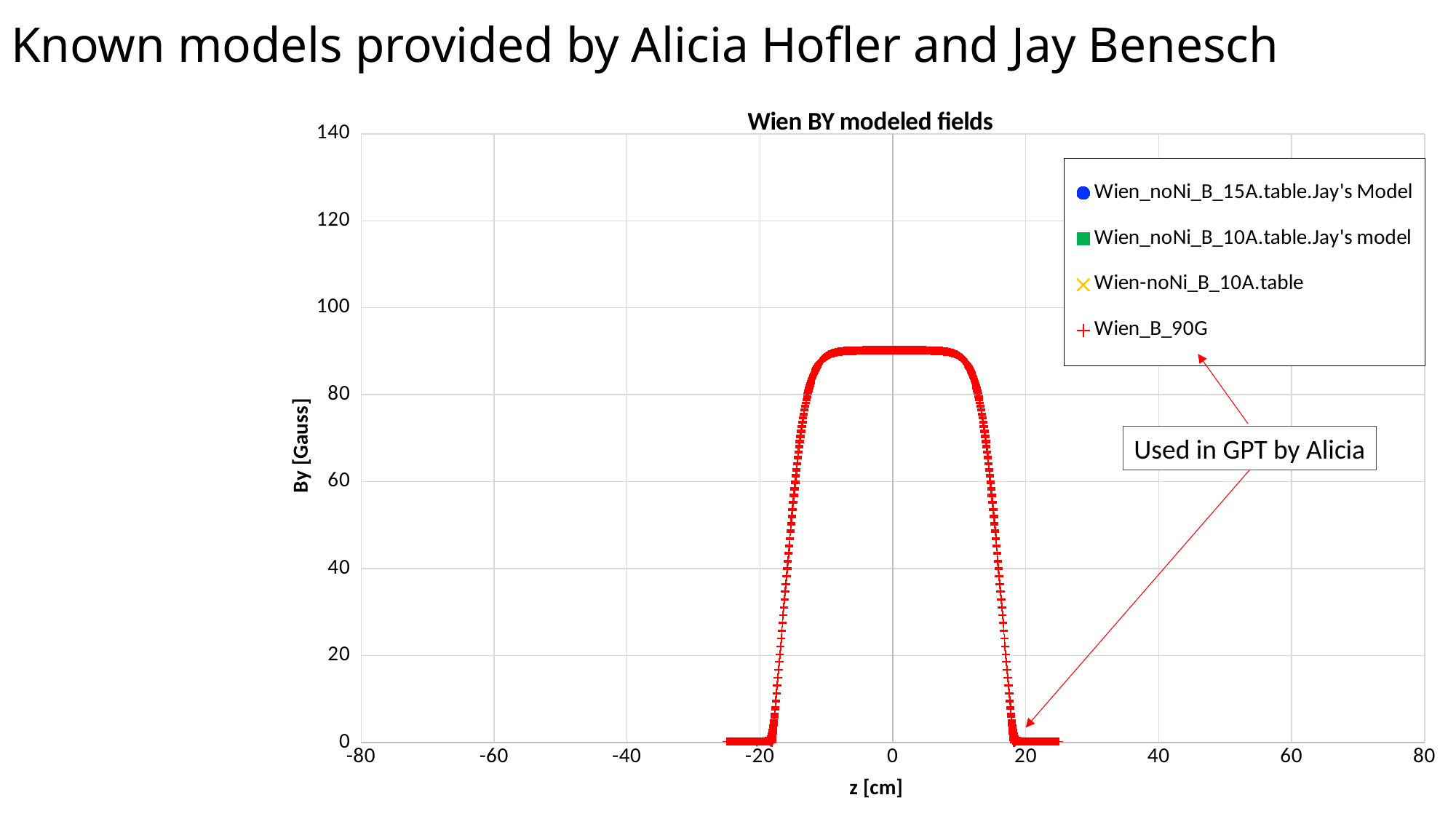
How many series does the legend of the chart list? 4 Do the values of the Wien_B_90G series rise or fall as z goes from -20 to 0? rise Is the value of the Wien_B_90G series at z = 0 greater or less than 80? greater Is the value of the Wien_B_90G series at z = -25 greater or less than 20? less Which is larger for the Wien_B_90G series: the value at z = 0 or the value at z = -15? z = 0 What is the highest value shown on the y axis of the chart? 140 What kind of chart is shown on the slide? scatter chart Do the values of the Wien_B_90G series rise or fall as z goes from 0 to 20? fall Is the value of the Wien_B_90G series at z = 20 greater or less than 40? less Which series does the annotation "Used in GPT by Alicia" point to? Wien_B_90G What is the title of the chart? Wien BY modeled fields